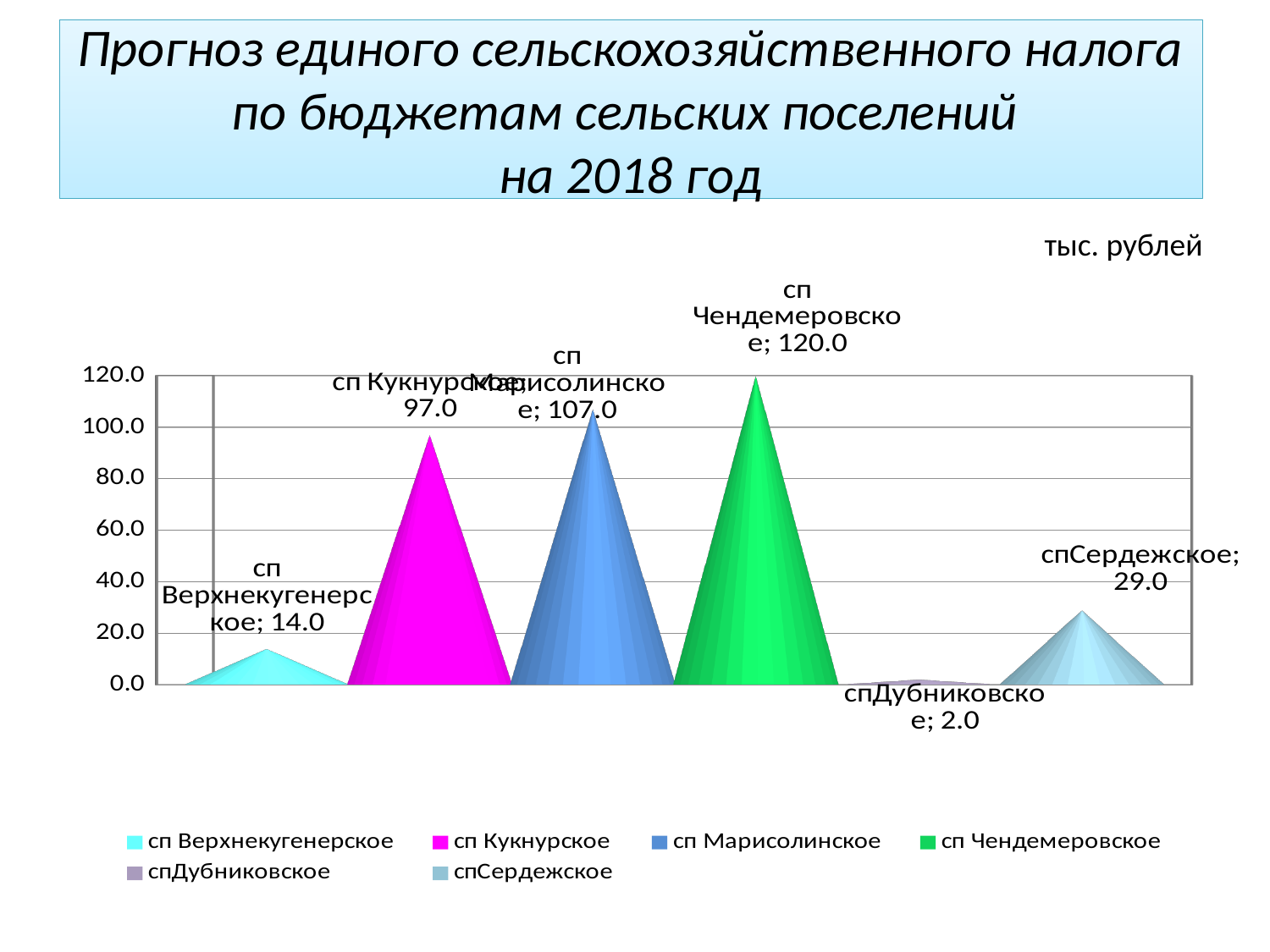
Which is larger, the value for сп Кукнурское or the value for сп Марисолинское? сп Марисолинское What is the forecast value for сп Чендемеровское? 120.0 What is the difference between the values for сп Чендемеровское and сп Марисолинское? 13.0 What is the forecast value for спСердежское? 29.0 What is the forecast value for спДубниковское? 2.0 Which settlement has the lowest forecast value? спДубниковское What is the forecast value for сп Кукнурское? 97.0 What kind of chart is shown on the slide? bar chart What unit of measurement is indicated above the chart? тыс. рублей How many settlements are plotted on the chart? 6 Which settlement has the highest forecast value? сп Чендемеровское How many entries does the legend list? 6